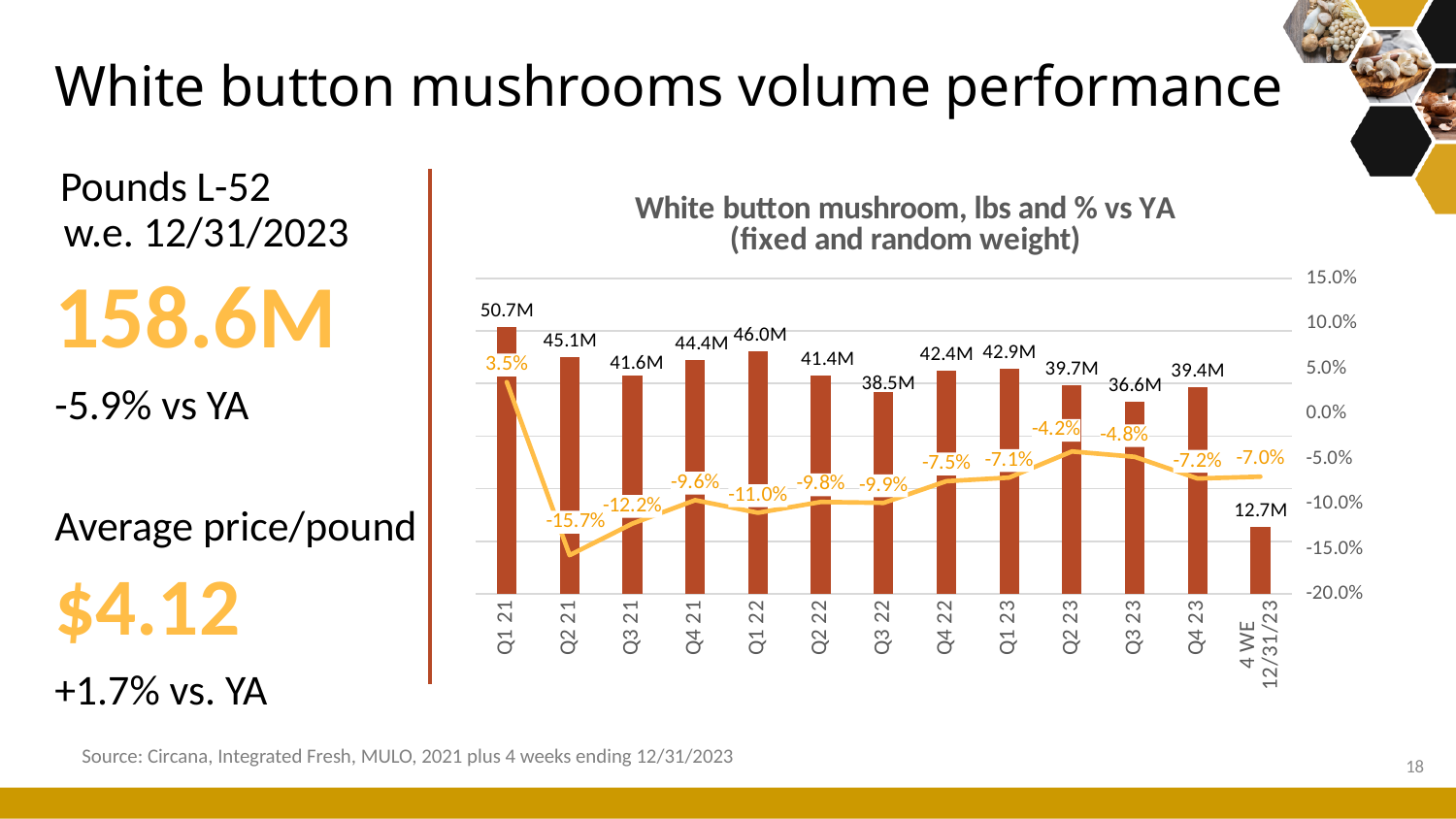
Does the % vs YA line rise or fall from Q2 21 to Q2 23? Rise What is the % vs YA value for Q2 23? -4.2% Which period has the lowest % vs YA value? Q2 21 Which period has the lowest volume bar? 4 WE 12/31/23 What is the volume in pounds for the 4 WE 12/31/23 period? 12.7M Which has the larger volume in pounds, Q4 21 or Q1 22? Q1 22 What is the difference in pounds between Q1 23 and Q3 23? 6.3M Which period has the highest volume in pounds? Q1 21 What kind of chart is this? Combination bar and line chart How many periods are shown on the x axis? 13 What is the volume in pounds for Q1 21? 50.7M What is the % vs YA value for Q2 21? -15.7%